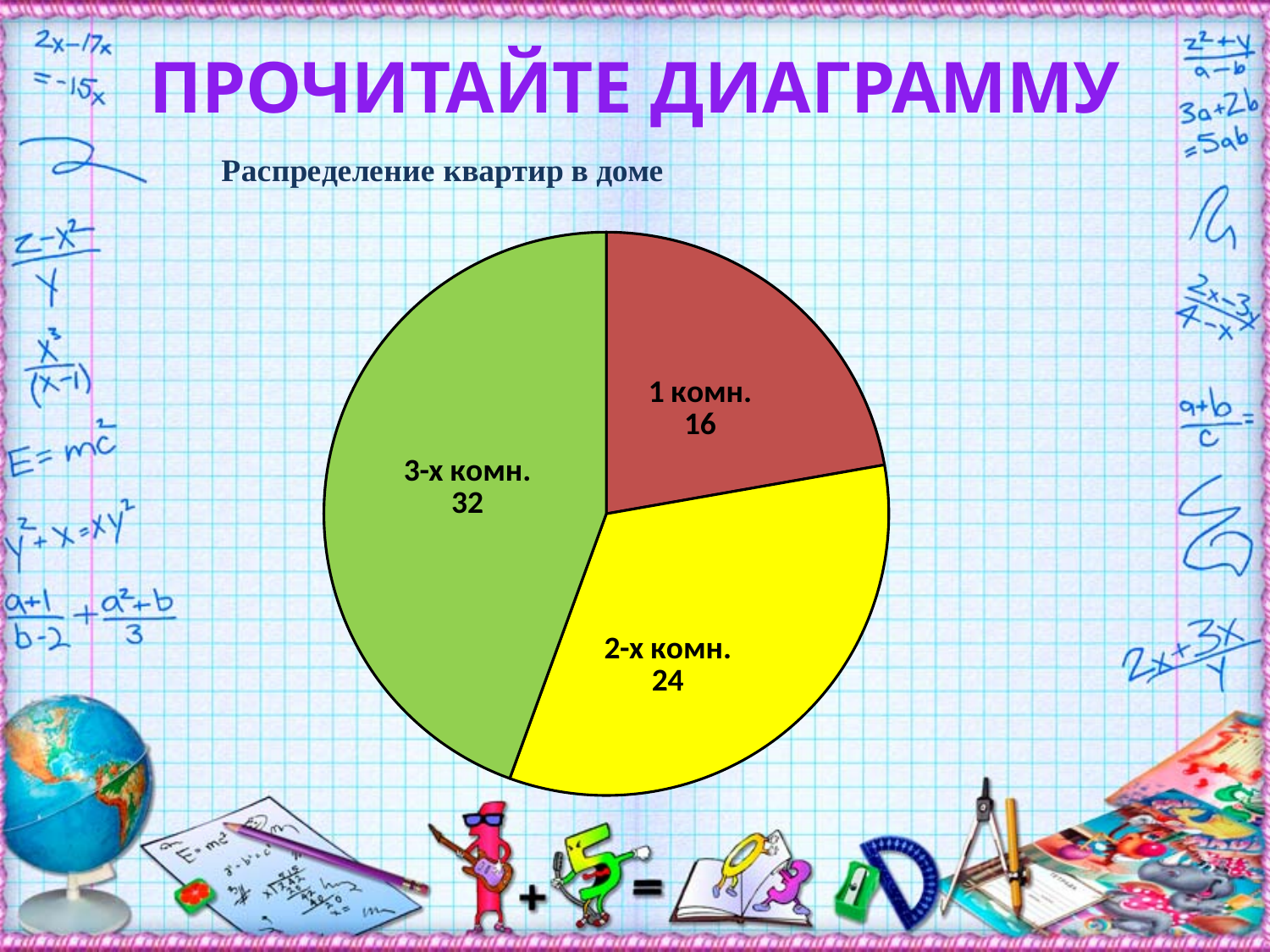
What is the value for 3-х комн.? 32 How many slices does the pie chart have? 3 Which is larger, the value for 2-х комн. or the value for 1 комн.? 2-х комн. Which category has the smallest slice? 1 комн. What is the value for 2-х комн.? 24 What is the value for 1 комн.? 16 What is the total of all three slices? 72 What fraction of the whole pie does the 2-х комн. slice represent? 1/3 Which category has the largest slice? 3-х комн. What is the title of the chart? Распределение квартир в доме What is the difference between the values for 3-х комн. and 1 комн.? 16 What kind of chart is shown on the slide? pie chart